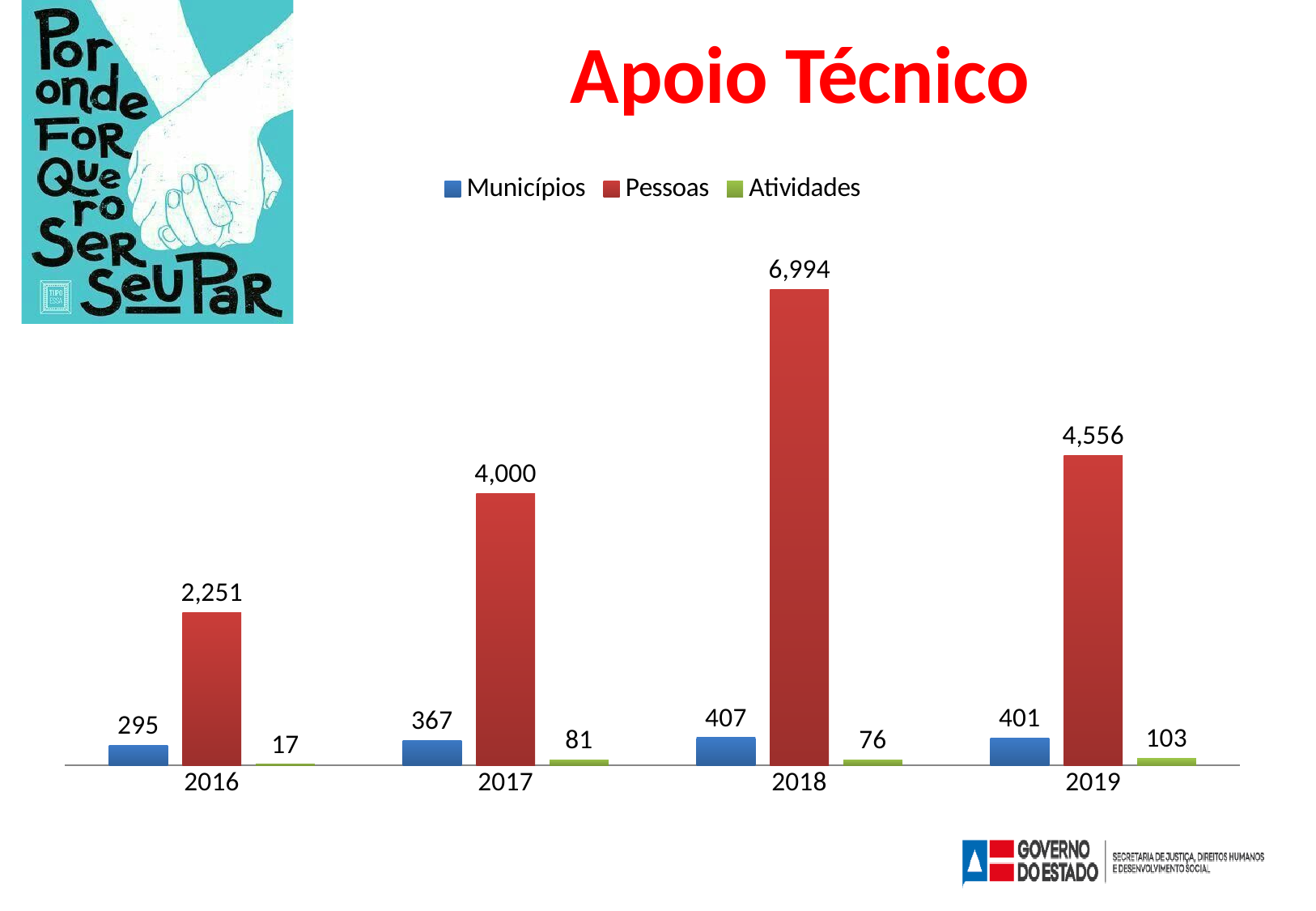
What is the value for Municípios in 2017? 367 How many series does the legend list? 3 What is the title of the chart? Apoio Técnico What is the value for Atividades in 2019? 103 In which year is the Pessoas value highest? 2018 In which year is the Atividades value lowest? 2016 How many years are shown on the x axis? 4 What kind of chart is shown on the slide? bar chart What is the difference between the Pessoas values for 2018 and 2019? 2,438 What is the value for Pessoas in 2018? 6,994 Does the Atividades value rise or fall from 2016 to 2017? rise Which is larger, the Municípios value for 2018 or for 2019? 2018